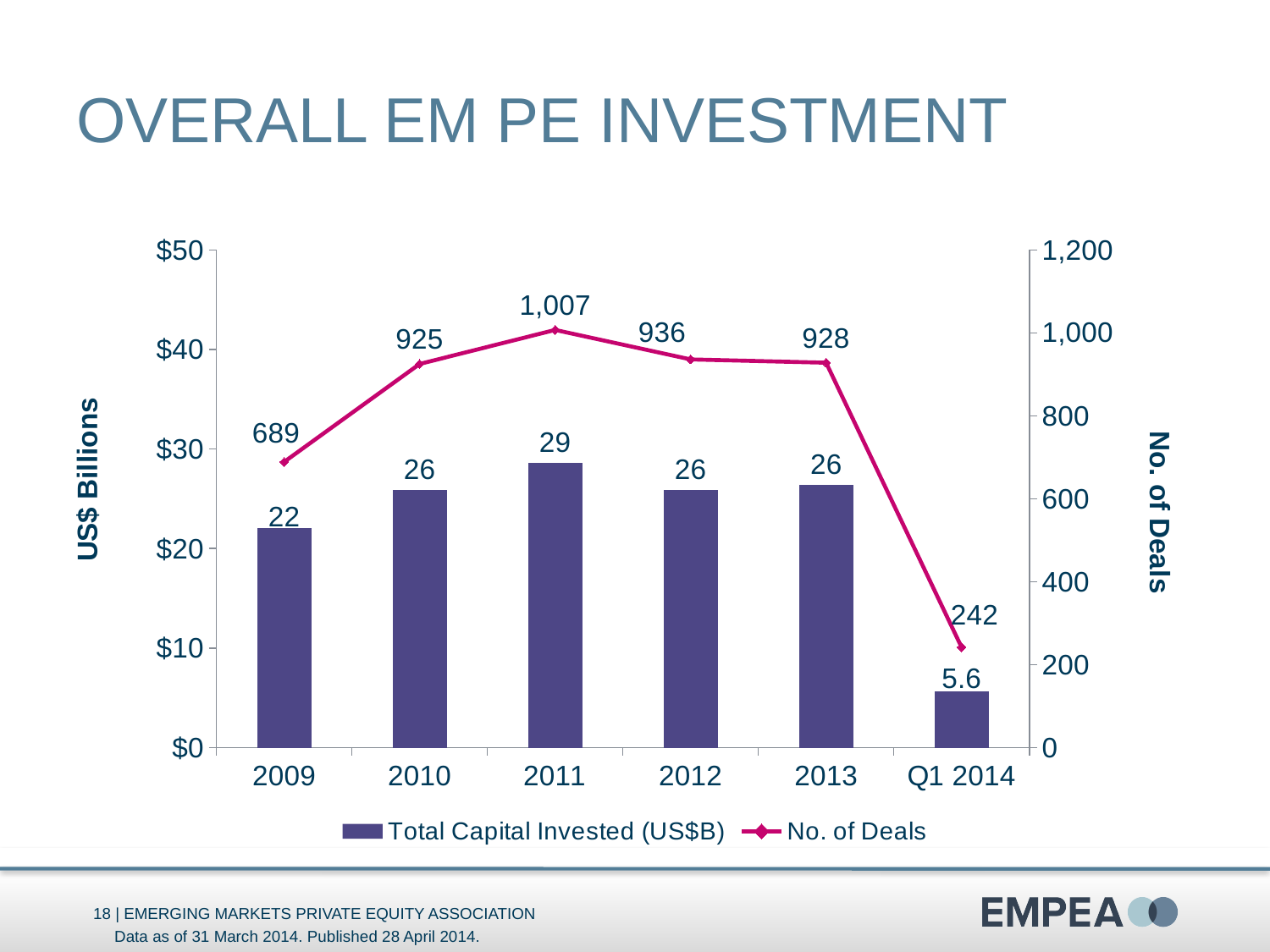
What is the difference in No. of Deals between 2011 and 2009? 318 What is the title of the chart? OVERALL EM PE INVESTMENT Did the No. of Deals rise or fall from 2013 to Q1 2014? Fall Which had more deals, 2012 or 2013? 2012 What kind of chart is used for Total Capital Invested (US$B)? Bar chart What was the No. of Deals in 2009? 689 How many periods are shown on the x axis? 6 Which period had the lowest Total Capital Invested (US$B)? Q1 2014 What was the Total Capital Invested (US$B) in 2011? 29 What was the Total Capital Invested (US$B) in Q1 2014? 5.6 How many series does the legend list? 2 Which year had the highest No. of Deals? 2011